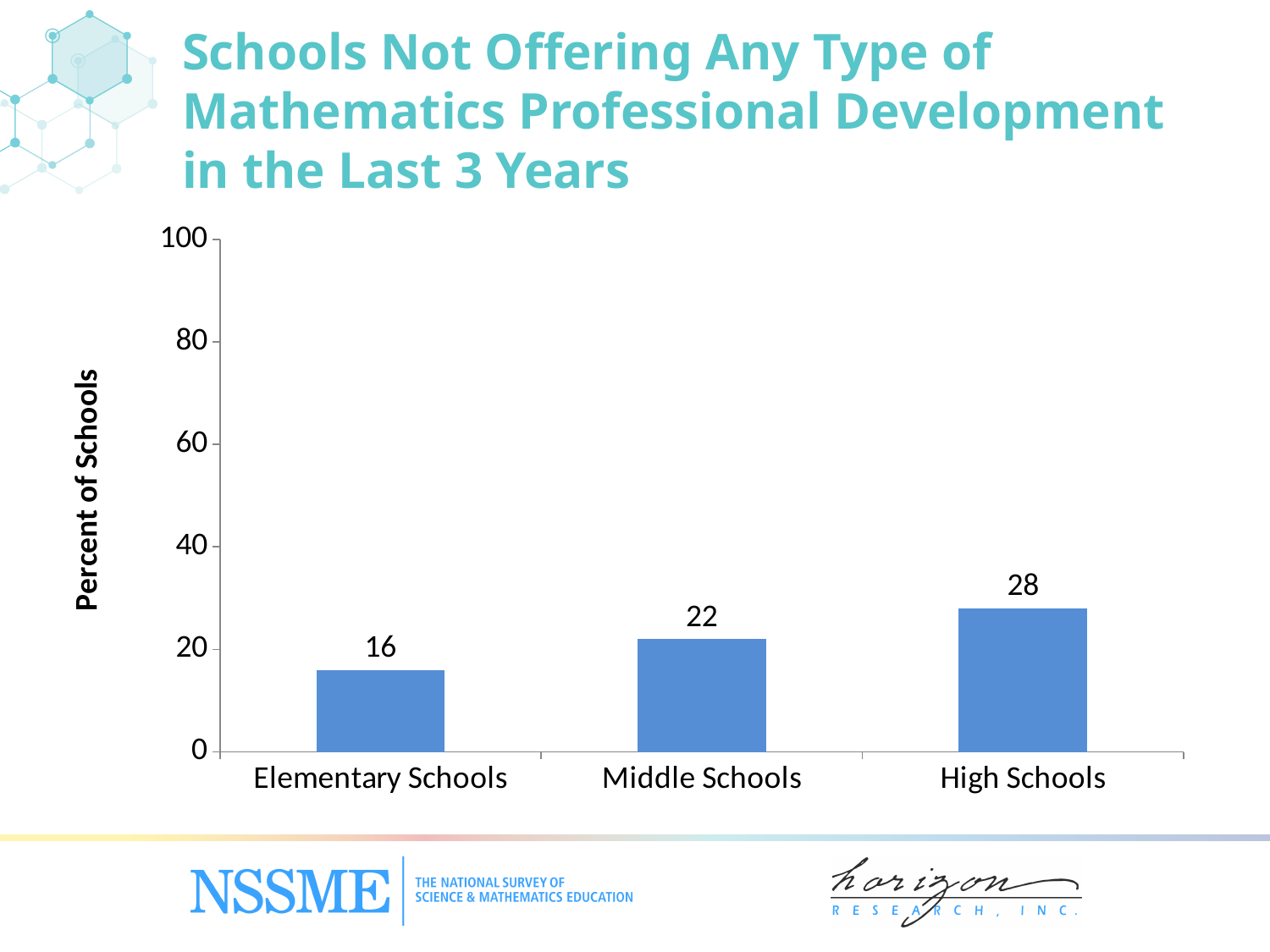
What is the value for Middle Schools? 22 What is the difference between the values for High Schools and Elementary Schools? 12 Which category has the highest value? High Schools What is the label of the y axis? Percent of Schools What kind of chart is shown on the slide? bar chart How many categories are shown on the x axis? 3 Which is larger, the value for Middle Schools or the value for High Schools? High Schools What is the value for High Schools? 28 What is the value for Elementary Schools? 16 Which category has the lowest value? Elementary Schools What is the difference between the values for Middle Schools and Elementary Schools? 6 Is the value for High Schools greater or less than 40? less